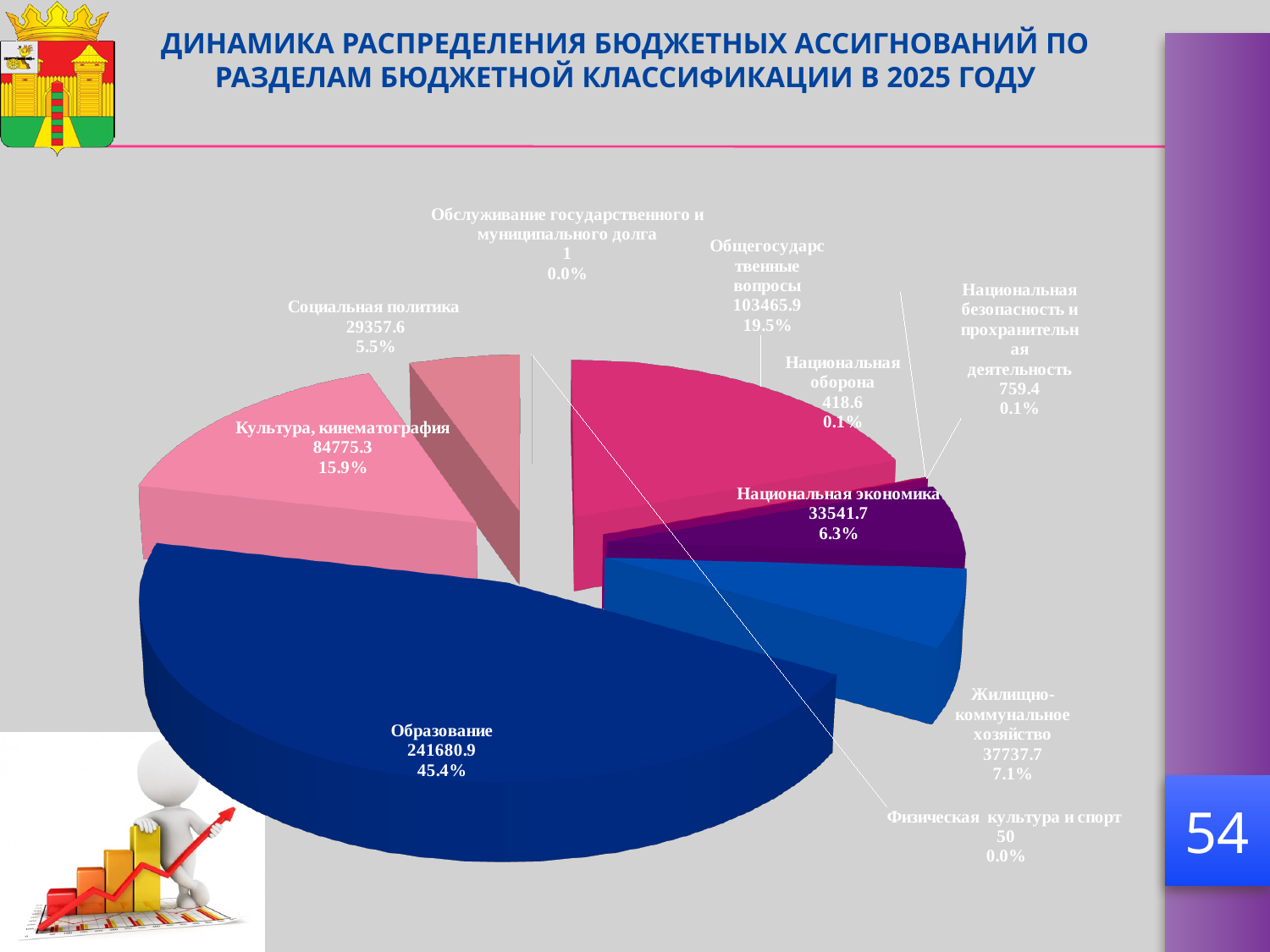
What is the difference between the values for Жилищно-коммунальное хозяйство and Национальная экономика? 4196.0 What is the difference between the values for Образование and Культура, кинематография? 156905.6 What is the value shown for Культура, кинематография? 84775.3 What year does the chart title refer to? 2025 What kind of chart is shown on the slide? Pie chart What share of the pie does Жилищно-коммунальное хозяйство represent? 7.1% Which is larger, the value for Социальная политика or the value for Национальная экономика? Национальная экономика What is the value shown for Образование? 241680.9 What share of the pie does Общегосударственные вопросы represent? 19.5% How many categories are shown in the pie chart? 10 Which category has the smallest value in the chart? Обслуживание государственного и муниципального долга Which category has the largest slice of the pie? Образование